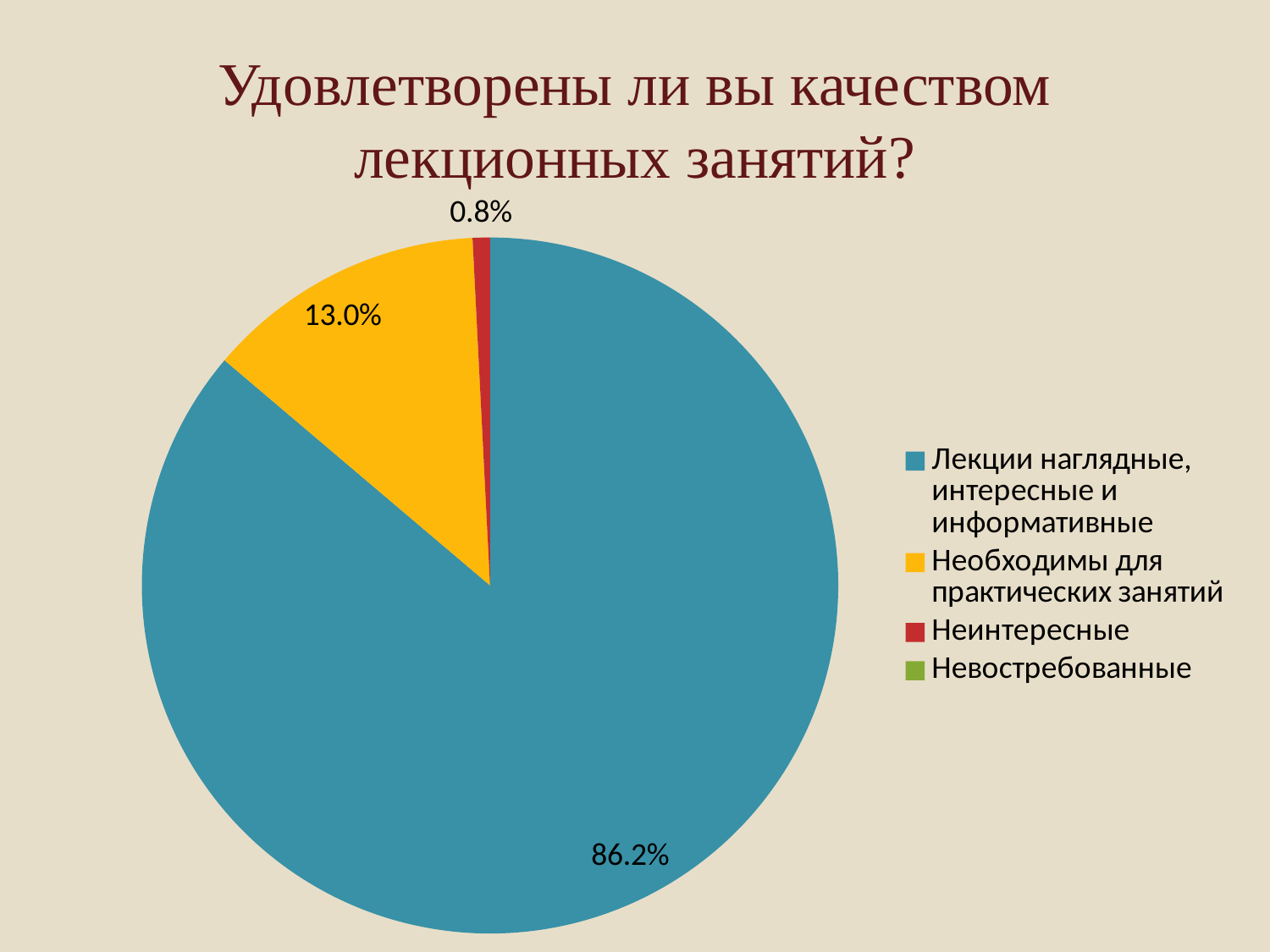
Which category has the largest slice of the pie? Лекции наглядные, интересные и информативные How many entries does the legend list? 4 Which is larger: the slice for "Необходимы для практических занятий" or the slice for "Неинтересные"? Необходимы для практических занятий What is the title of the chart? Удовлетворены ли вы качеством лекционных занятий? What colour is the slice for "Необходимы для практических занятий"? Yellow What share of the pie is labelled for "Неинтересные"? 0.8% Which of the labelled slices is the smallest? Неинтересные What share of the pie is labelled for "Необходимы для практических занятий"? 13.0% What is the difference between the shares for "Лекции наглядные, интересные и информативные" and "Необходимы для практических занятий"? 73.2% What share of the pie is labelled for "Лекции наглядные, интересные и информативные"? 86.2% What kind of chart is shown on the slide? Pie chart What is the difference between the shares for "Необходимы для практических занятий" and "Неинтересные"? 12.2%